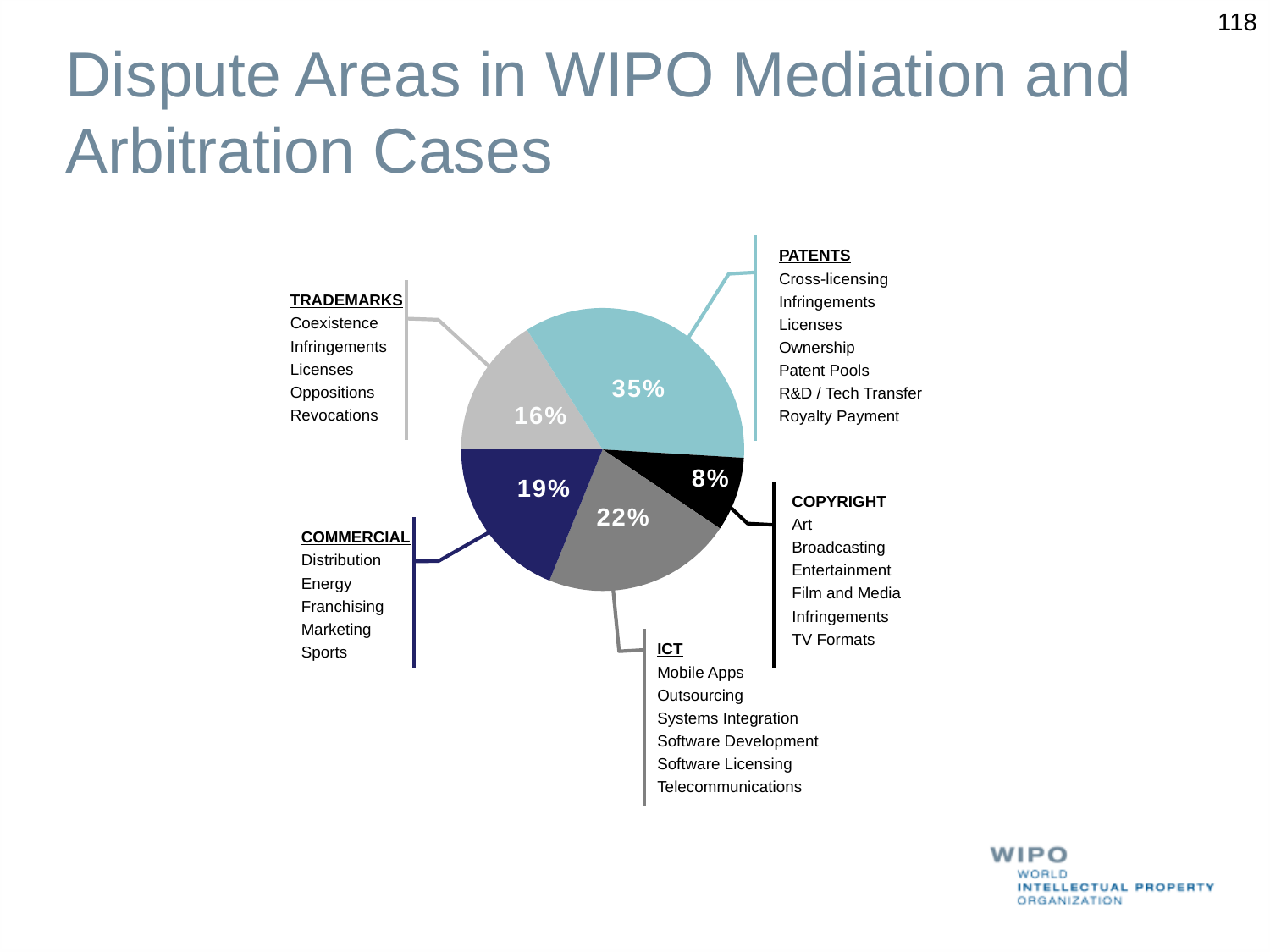
How many dispute areas (slices) does the pie chart show? 5 What share of cases is in the Copyright dispute area? 8% Which dispute area has a larger share, Commercial or Trademarks? Commercial What kind of chart is shown on the slide? pie chart What share of cases is in the Commercial dispute area? 19% How many percentage points larger is the Patents share than the ICT share? 13 Which dispute area has the smallest share of the pie? Copyright Which dispute area has the largest share of the pie? Patents What share of cases is in the ICT dispute area? 22% What share of WIPO mediation and arbitration cases is in the Patents dispute area? 35% What share of cases is in the Trademarks dispute area? 16% What is the title of the slide containing the pie chart? Dispute Areas in WIPO Mediation and Arbitration Cases